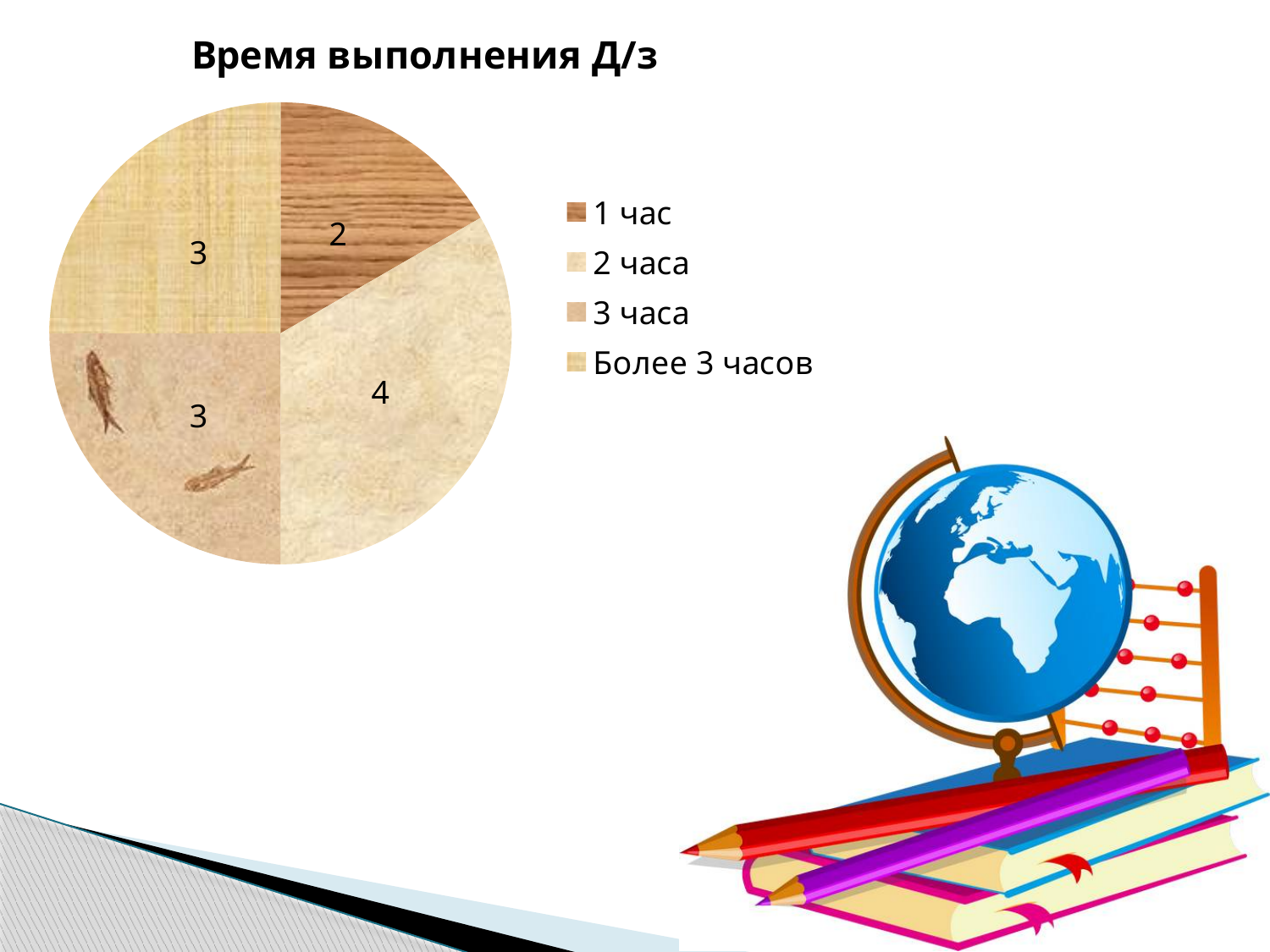
What is the value for the "3 часа" slice? 3 What is the value for the "Более 3 часов" slice? 3 How many categories does the legend list? 4 What share of the pie does the "3 часа" slice represent? 25% What is the value for the "2 часа" slice? 4 What is the difference between the values for "2 часа" and "1 час"? 2 What is the value for the "1 час" slice? 2 Which category has the largest slice? 2 часа What is the title of the chart? Время выполнения Д/з What kind of chart is shown on the slide? pie chart Which is larger, the value for "2 часа" or the value for "3 часа"? 2 часа Which category has the smallest slice? 1 час